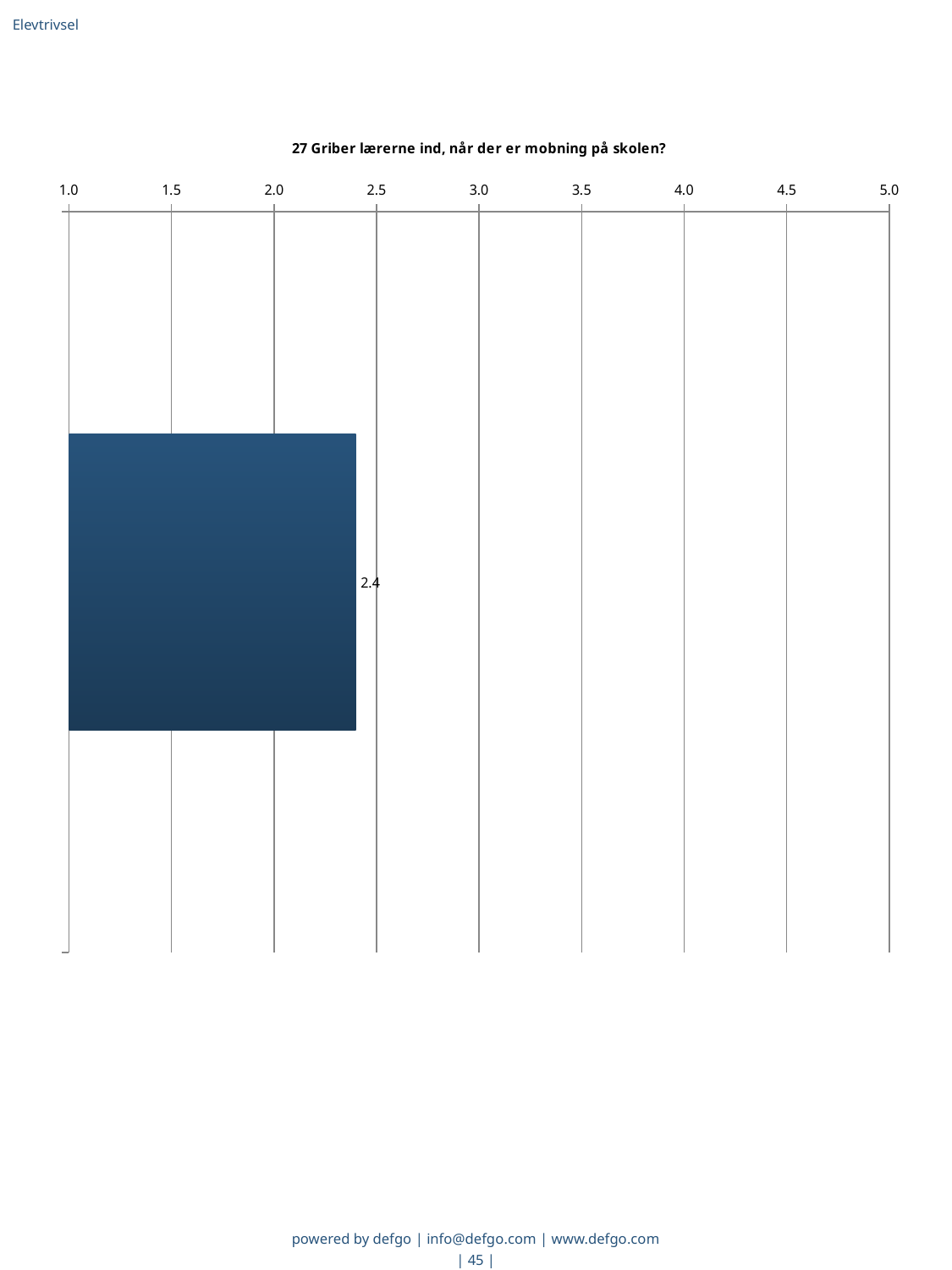
Is the bar in the chart horizontal or vertical? horizontal What kind of chart is shown on the slide? bar chart What is the highest value shown on the chart's axis? 5.0 What value is shown by the bar in the chart? 2.4 Is the value of the bar greater or less than 2.0? greater What is the title of the chart? 27 Griber lærerne ind, når der er mobning på skolen? How many bars are plotted in the chart? 1 Is the value of the bar greater or less than 2.5? less